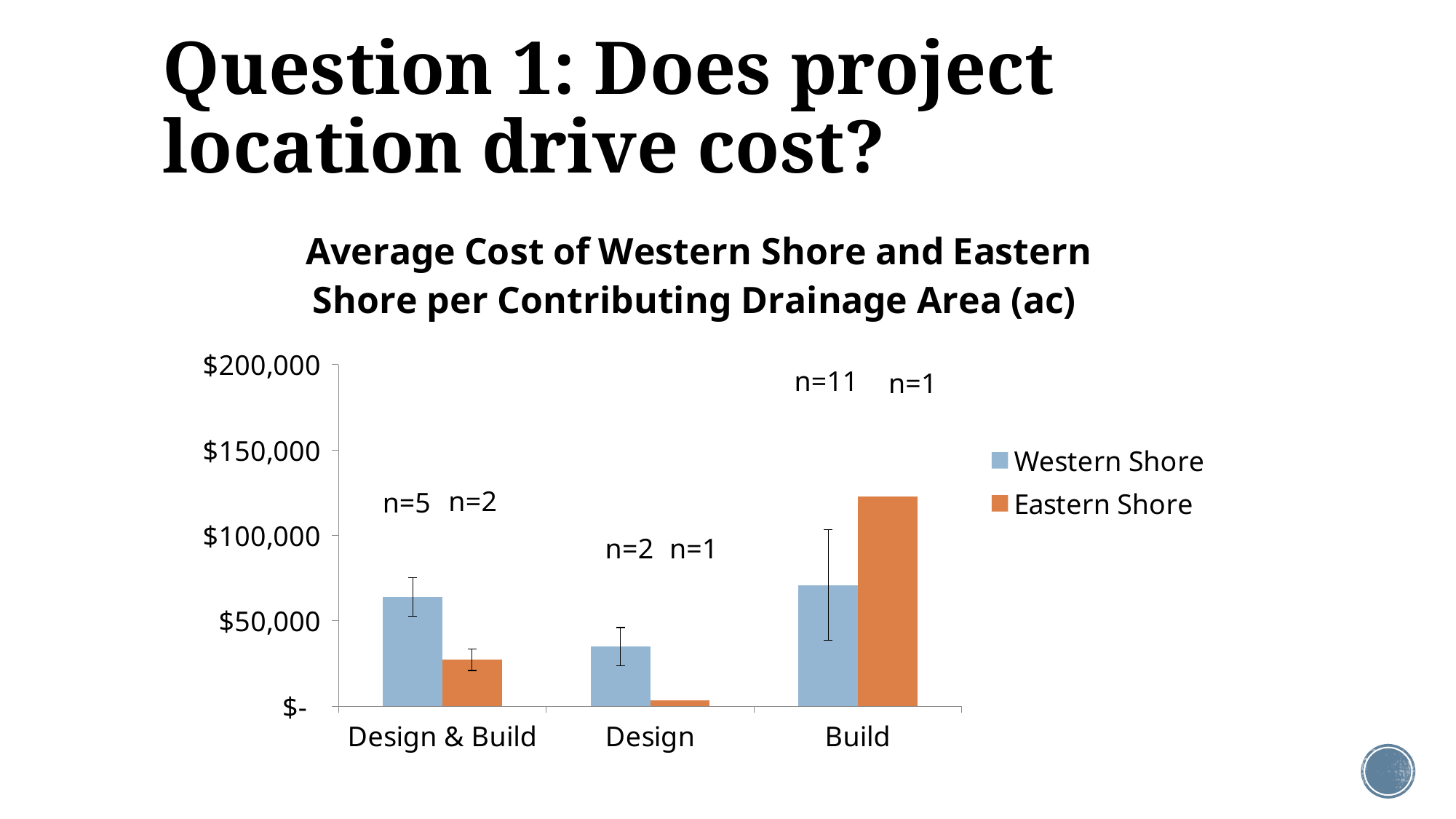
Is the Western Shore value for Design greater or less than $50,000? less Which category has the lowest Eastern Shore value? Design Which category has the lowest Western Shore value? Design For the Build category, which series has the larger value, Western Shore or Eastern Shore? Eastern Shore What kind of chart is shown on the slide? bar chart For the Design & Build category, which series has the larger value, Western Shore or Eastern Shore? Western Shore Is the Eastern Shore value for Build greater or less than $100,000? greater How many series does the legend list? 2 What is the title of the chart? Average Cost of Western Shore and Eastern Shore per Contributing Drainage Area (ac) Which category has the highest Eastern Shore value? Build How many categories are shown on the x axis? 3 What is the sample size (n) shown for Western Shore in the Build category? n=11